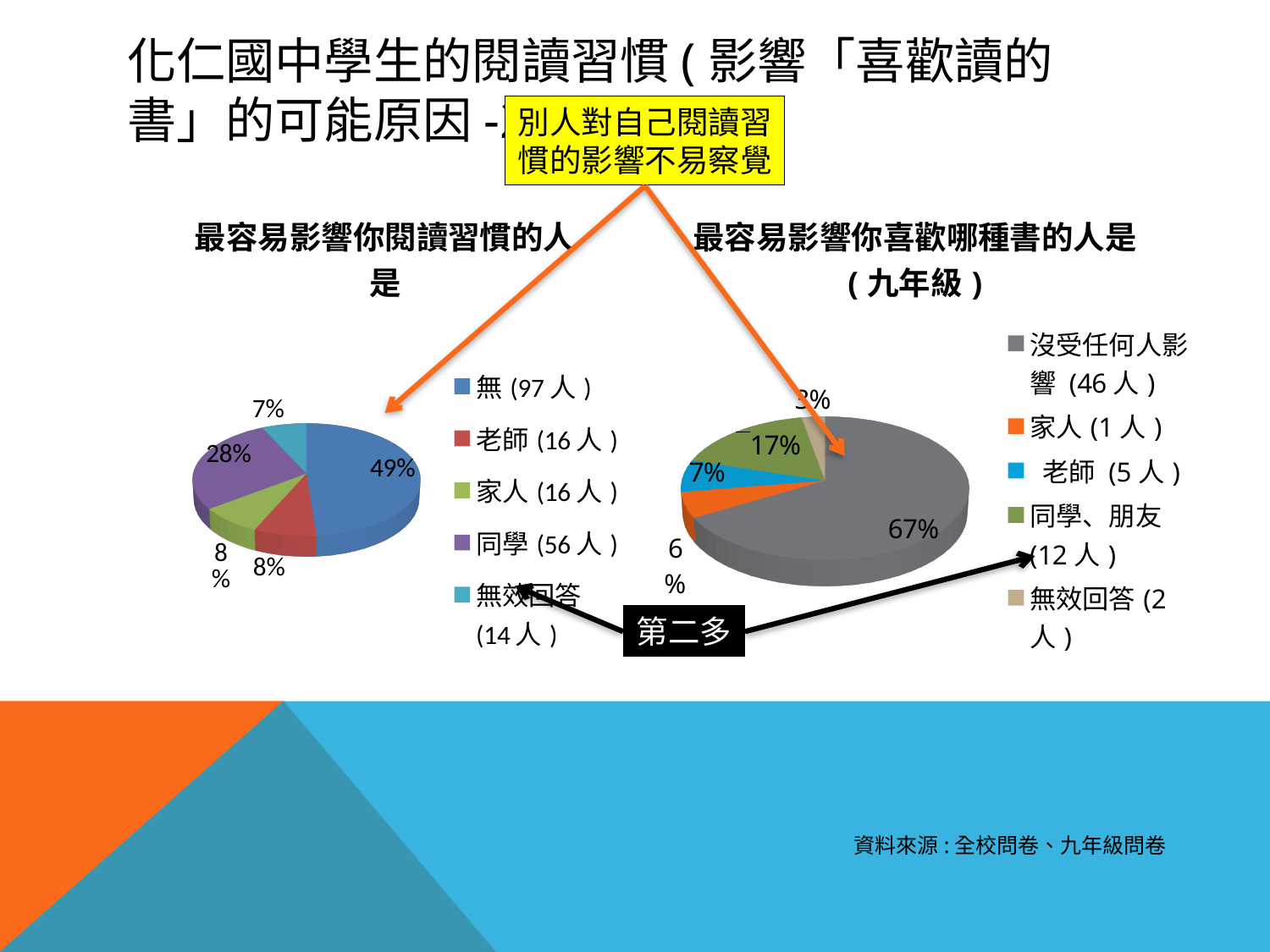
In the left chart 「最容易影響你閱讀習慣的人是」, what share of the pie is 無? 49% In the left chart 「最容易影響你閱讀習慣的人是」, how many people does the legend give for 同學? 56 人 In the right chart 「最容易影響你喜歡哪種書的人是（九年級）」, how many categories does the legend list? 5 In the left chart 「最容易影響你閱讀習慣的人是」, how many categories does the legend list? 5 In the right chart 「最容易影響你喜歡哪種書的人是（九年級）」, which category has the fewest people according to the legend? 家人 In the right chart 「最容易影響你喜歡哪種書的人是（九年級）」, which category has the largest slice? 沒受任何人影響 In the left chart 「最容易影響你閱讀習慣的人是」, what share of the pie is 無效回答? 7% In the left chart 「最容易影響你閱讀習慣的人是」, which category has the largest slice? 無 In the right chart 「最容易影響你喜歡哪種書的人是（九年級）」, what share of the pie is 沒受任何人影響? 67% In the right chart 「最容易影響你喜歡哪種書的人是（九年級）」, how many people does the legend give for 同學、朋友? 12 人 What kind of chart is the left chart titled 「最容易影響你閱讀習慣的人是」? pie chart